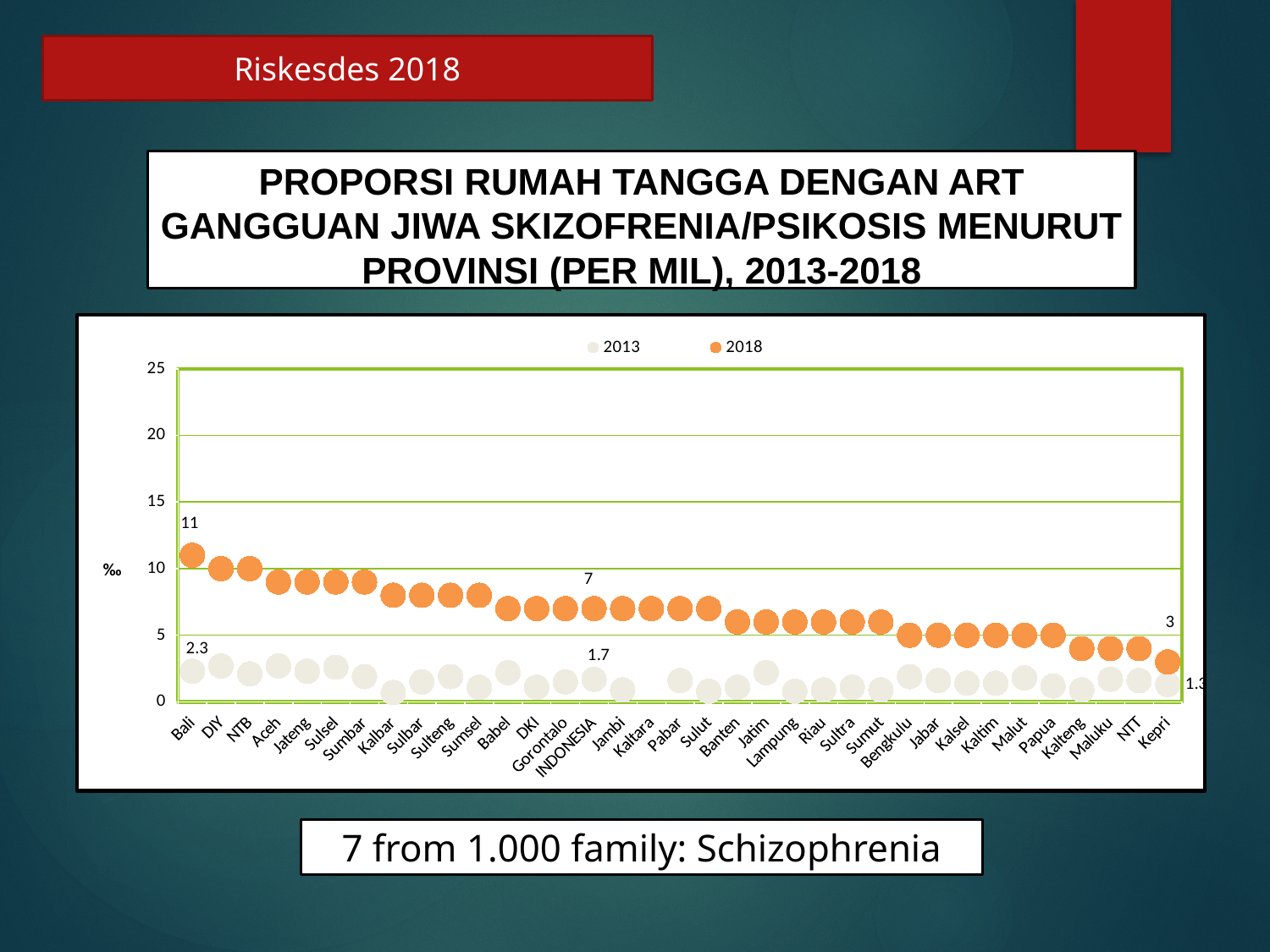
What is the 2013 value for Bali? 2.3 What is the 2018 value for Kepri? 3 Is the 2018 value for DIY greater or less than 5? greater What is the 2018 value for INDONESIA? 7 Which province has the highest 2018 value? Bali How many series does the legend list? 2 Which province has the lowest 2018 value? Kepri What is the 2013 value for INDONESIA? 1.7 What is the 2018 value for Bali? 11 Which is larger for INDONESIA, the 2018 value or the 2013 value? 2018 What is the difference between the 2018 values for Bali and Kepri? 8 Do the 2018 values rise or fall from left to right along the x axis? fall